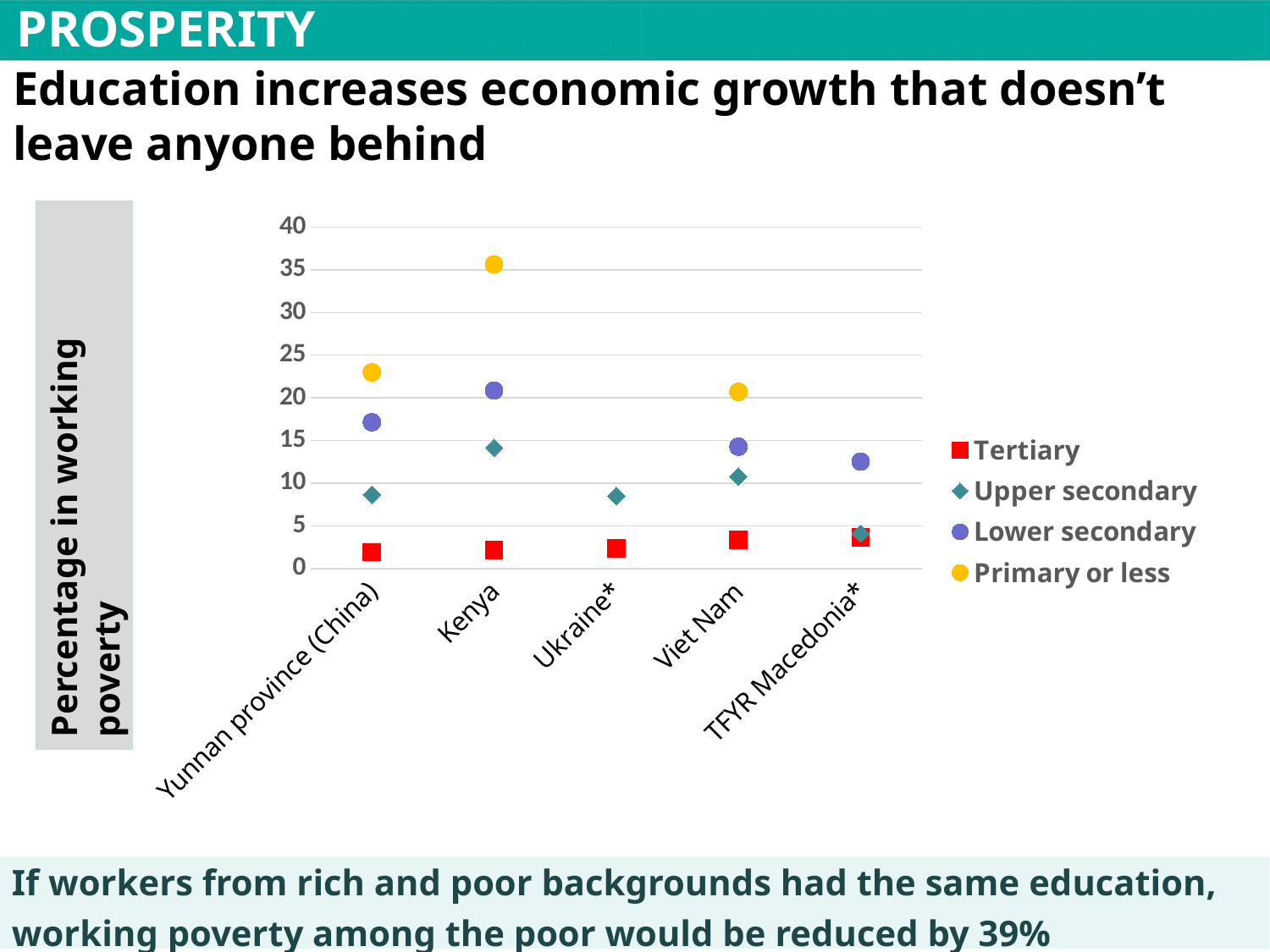
Is the Tertiary value for Viet Nam greater or less than 5? less How many series does the chart legend list? 4 What is the label on the y axis of the chart? Percentage in working poverty How many countries or regions are shown on the x axis of the chart? 5 Which is larger, the Lower secondary value for Kenya or for TFYR Macedonia*? Kenya Is the Primary or less value for Kenya greater or less than 30? greater Is the Upper secondary value for Ukraine* greater or less than 5? greater Which country or region has no Lower secondary marker plotted? Ukraine* Which country or region has the highest value for Primary or less? Kenya What kind of chart is shown on the slide? Scatter (dot) chart